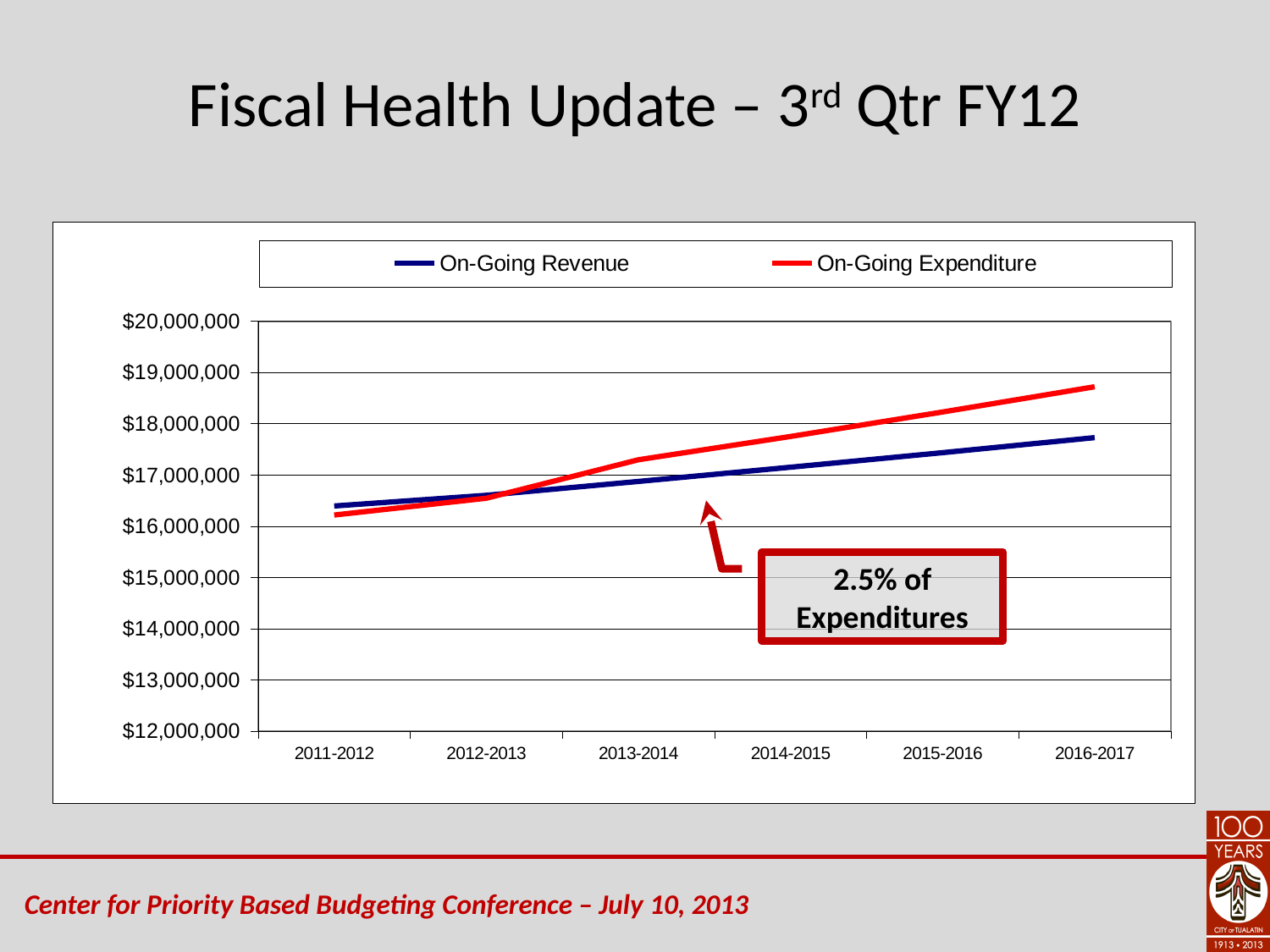
Does the On-Going Revenue line rise or fall from 2011-2012 to 2016-2017? rise Is the On-Going Revenue value for 2016-2017 greater or less than $18,000,000? less Is the On-Going Expenditure value for 2013-2014 greater or less than $17,000,000? greater In 2015-2016, which is larger: On-Going Revenue or On-Going Expenditure? On-Going Expenditure Is the On-Going Expenditure value for 2016-2017 greater or less than $18,000,000? greater How many series does the legend list? 2 Does the On-Going Expenditure line rise or fall from 2011-2012 to 2016-2017? rise What kind of chart is shown on the slide? line chart In 2016-2017, which is larger: On-Going Revenue or On-Going Expenditure? On-Going Expenditure What text is shown in the callout box pointing at the gap between the two lines? 2.5% of Expenditures How many fiscal years are plotted along the x axis? 6